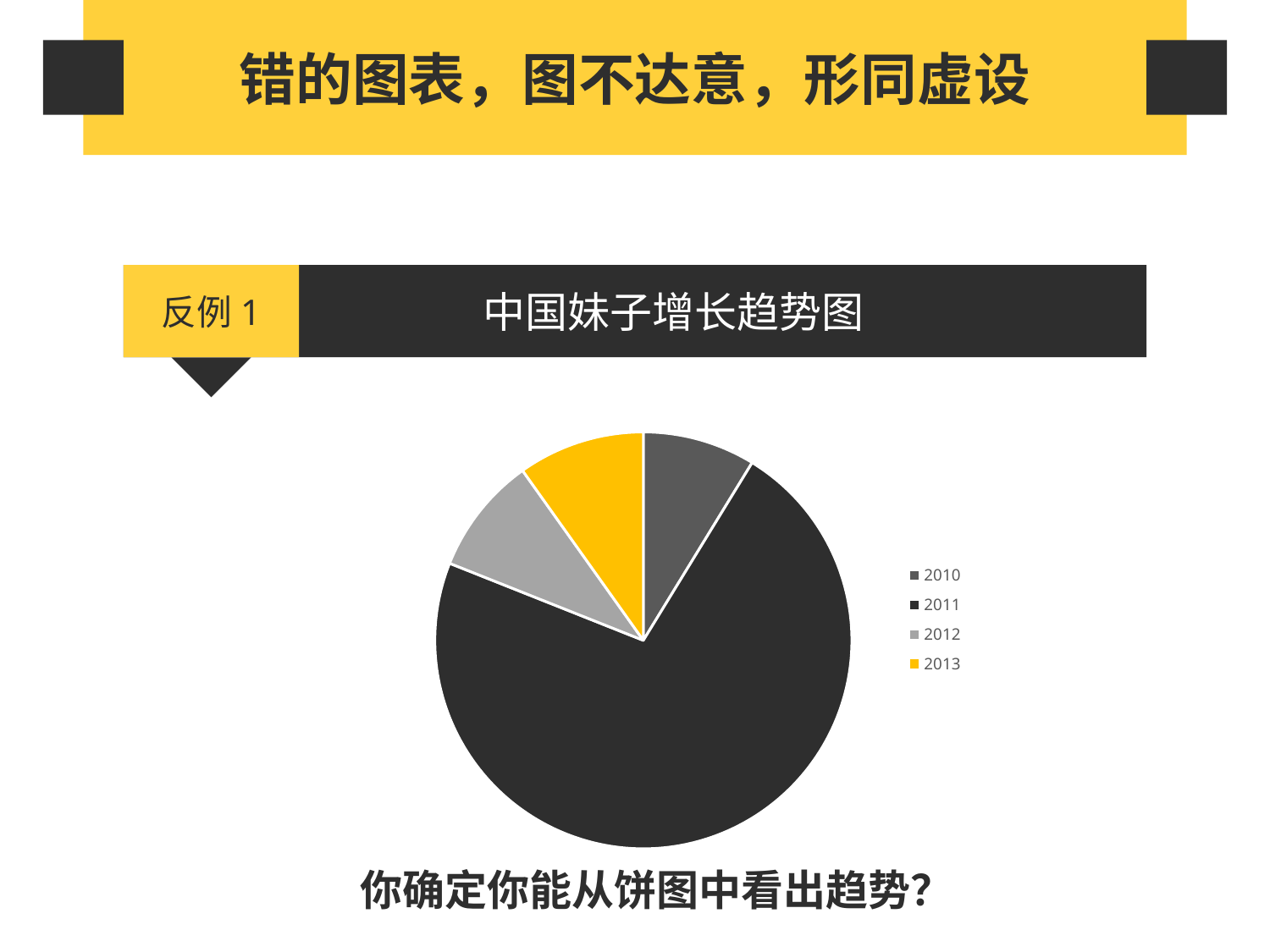
What is the title shown above the pie chart? 中国妹子增长趋势图 What kind of chart is shown on the slide? pie chart Which slice is larger in the pie chart, 2012 or 2011? 2011 Which year has the largest slice in the pie chart? 2011 How many slices does the pie chart have? 4 Which year is shown in yellow in the pie chart? 2013 How many entries does the legend of the pie chart list? 4 Which slice is larger in the pie chart, 2013 or 2011? 2011 Which slice is larger in the pie chart, 2011 or 2010? 2011